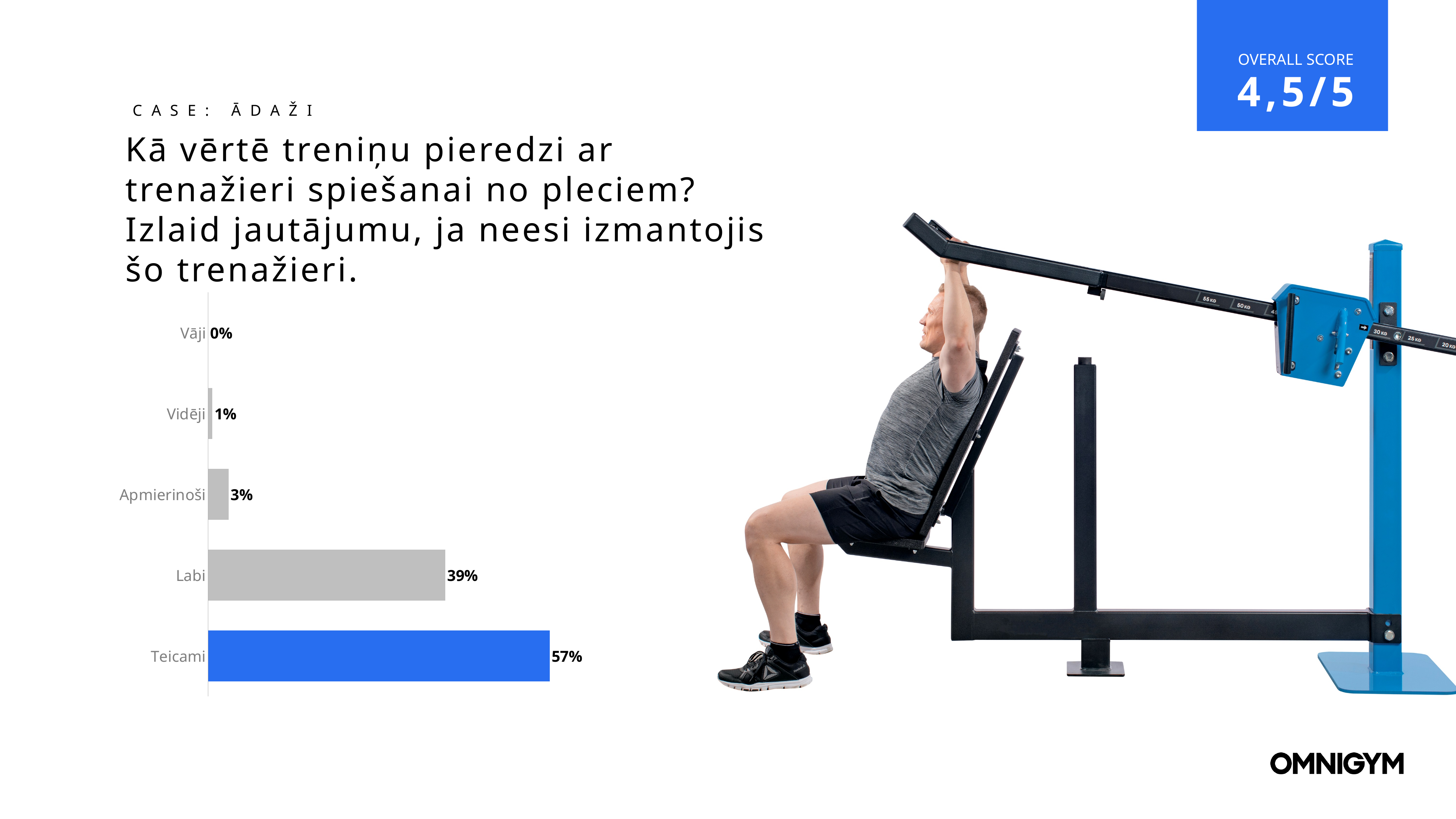
What is the value for Apmierinoši? 3% Which category has the highest value? Teicami How many categories does the chart show? 5 What is the value for Labi? 39% Which bar is coloured blue rather than grey? Teicami What is the value for Teicami? 57% What is the difference between the values for Teicami and Labi? 18% Which category has the lowest value? Vāji What is the value for Vidēji? 1% What kind of chart is shown on the slide? Bar chart Which is larger, the value for Labi or the value for Apmierinoši? Labi What is the value for Vāji? 0%